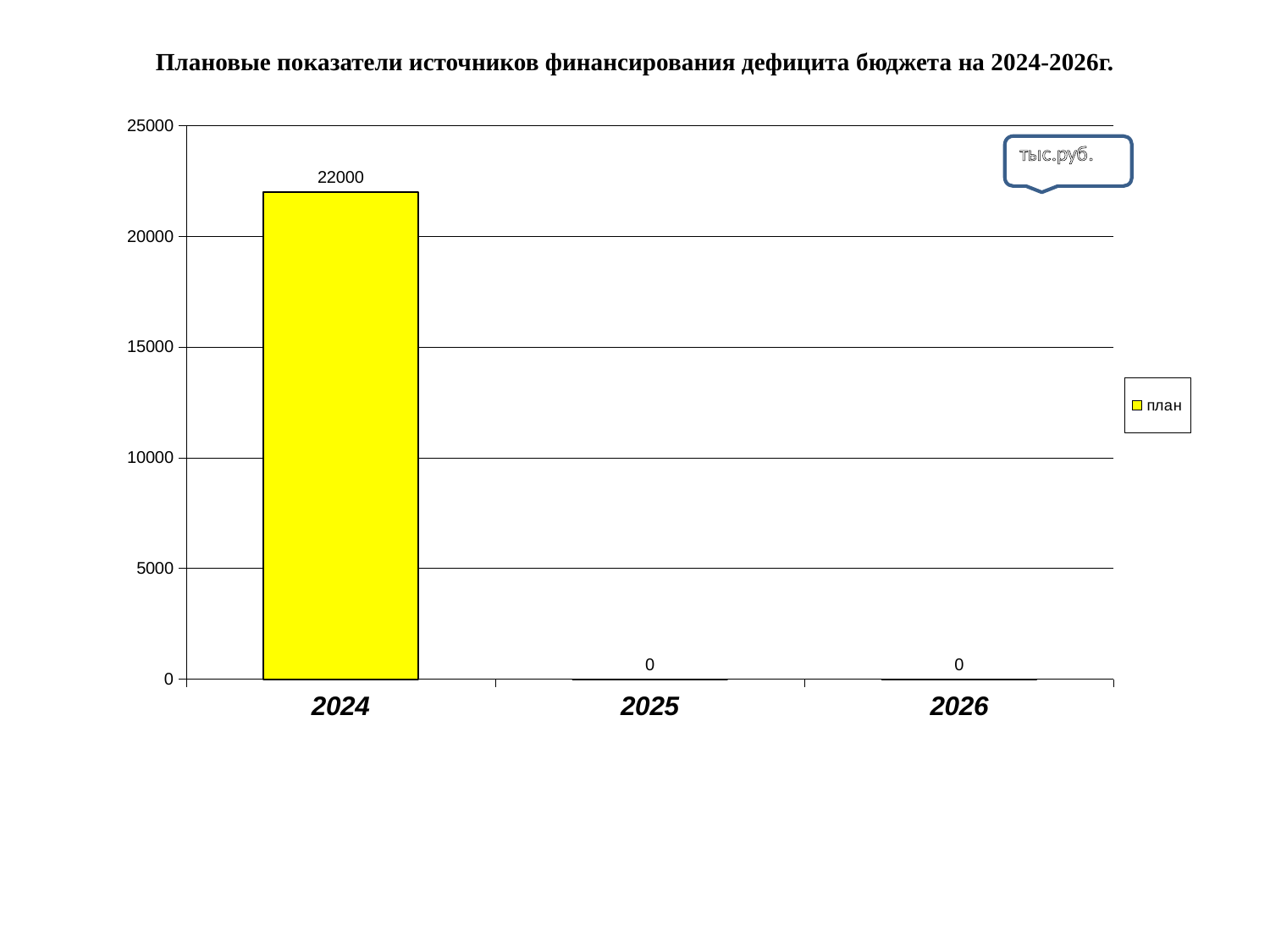
Which is larger, the planned value for 2024 or for 2026? 2024 What kind of chart is shown on the slide? bar chart Do the values rise or fall from 2024 to 2026? fall How many years are shown on the x axis? 3 What is the planned value for 2025? 0 What is the planned value for 2024? 22000 What is the planned value for 2026? 0 How many series does the legend list? 1 What is the name of the series in the legend? план Which year has the highest planned value? 2024 Is the value for 2024 greater or less than 20000? greater What is the difference between the planned values for 2024 and 2025? 22000